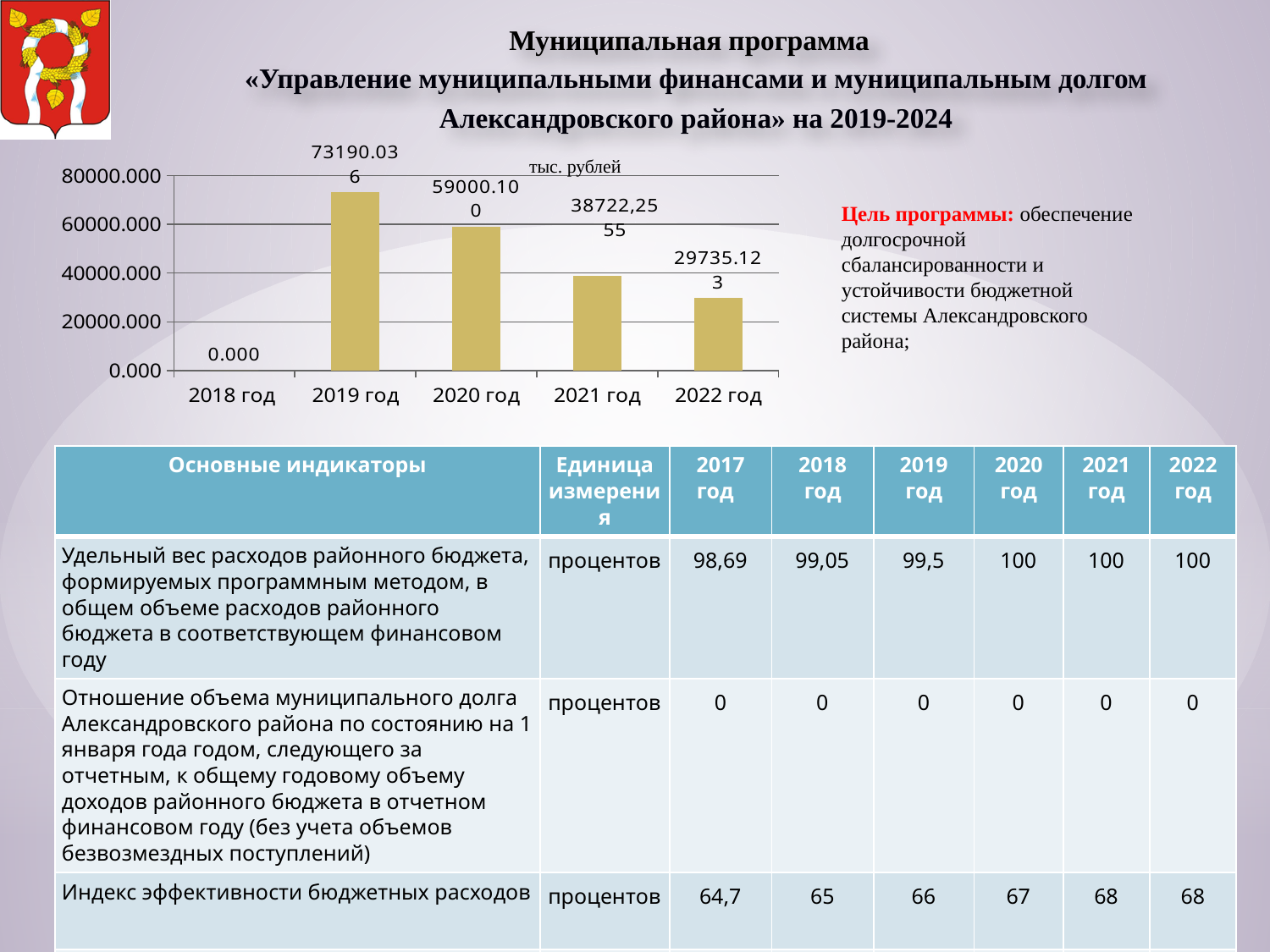
Is the value for 2021 год greater or less than 40000.000? less What kind of chart is shown on the slide? bar chart What unit label is printed above the chart? тыс. рублей How many year categories are shown on the x axis of the chart? 5 Which year has the highest bar in the chart? 2019 год Which year has the lowest value in the chart? 2018 год Is the value for 2019 год greater or less than 60000.000? greater Which is larger, the value for 2020 год or the value for 2021 год? 2020 год From 2019 год to 2022 год, do the values in the chart rise or fall? fall What is the value shown for 2018 год in the chart? 0.000 Is the value for 2022 год greater or less than 20000.000? greater